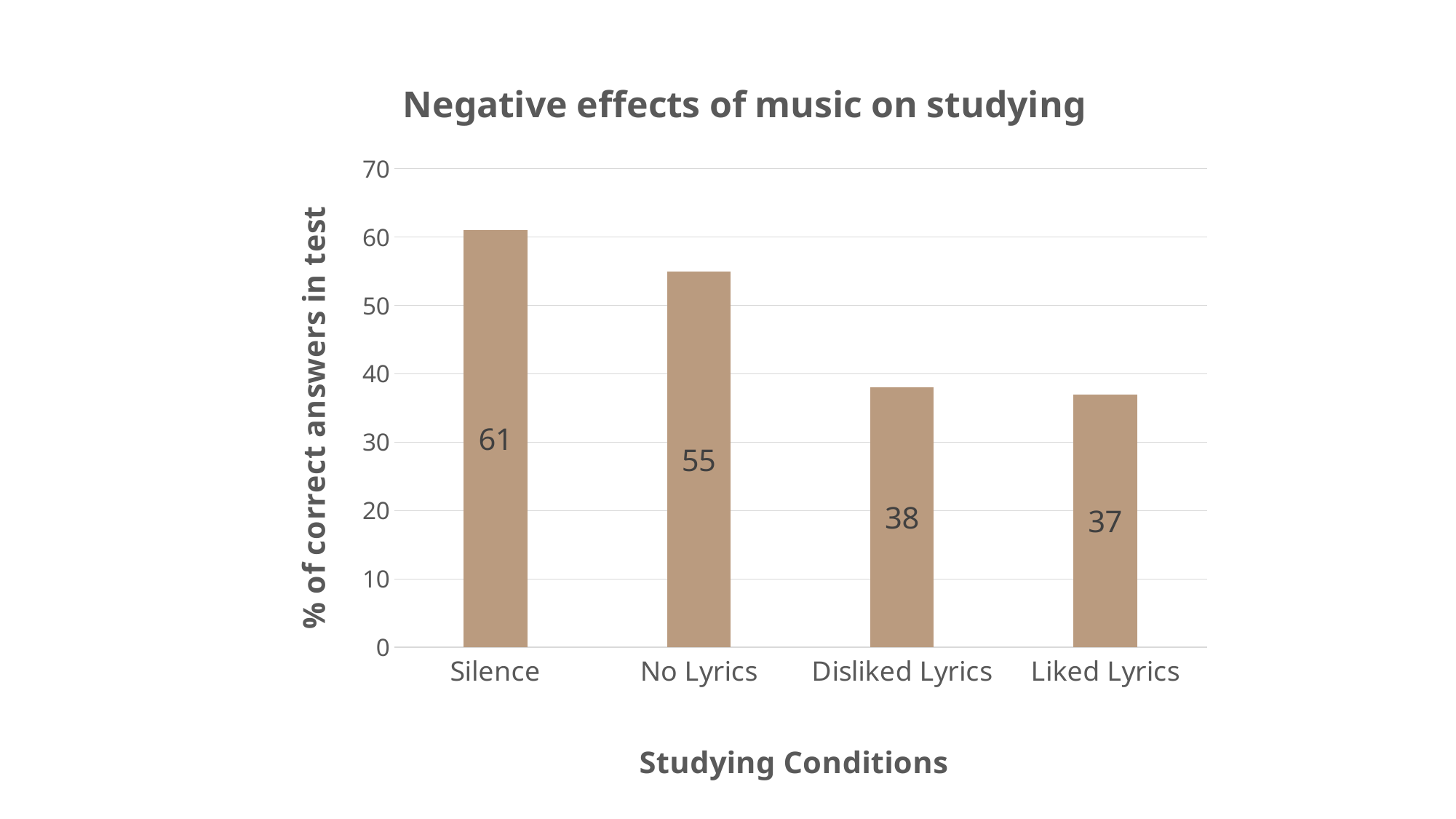
What is the value for No Lyrics? 55 What is the value for Disliked Lyrics? 38 Which studying condition has the highest percentage of correct answers? Silence Which studying condition has the lowest percentage of correct answers? Liked Lyrics What is the value for Silence? 61 How many studying conditions are shown on the x axis? 4 What is the difference between the values for No Lyrics and Disliked Lyrics? 17 Which is larger, the value for Silence or the value for Disliked Lyrics? Silence What is the difference between the values for Silence and No Lyrics? 6 What is the title of the chart? Negative effects of music on studying What kind of chart is shown on the slide? Bar chart What is the value for Liked Lyrics? 37